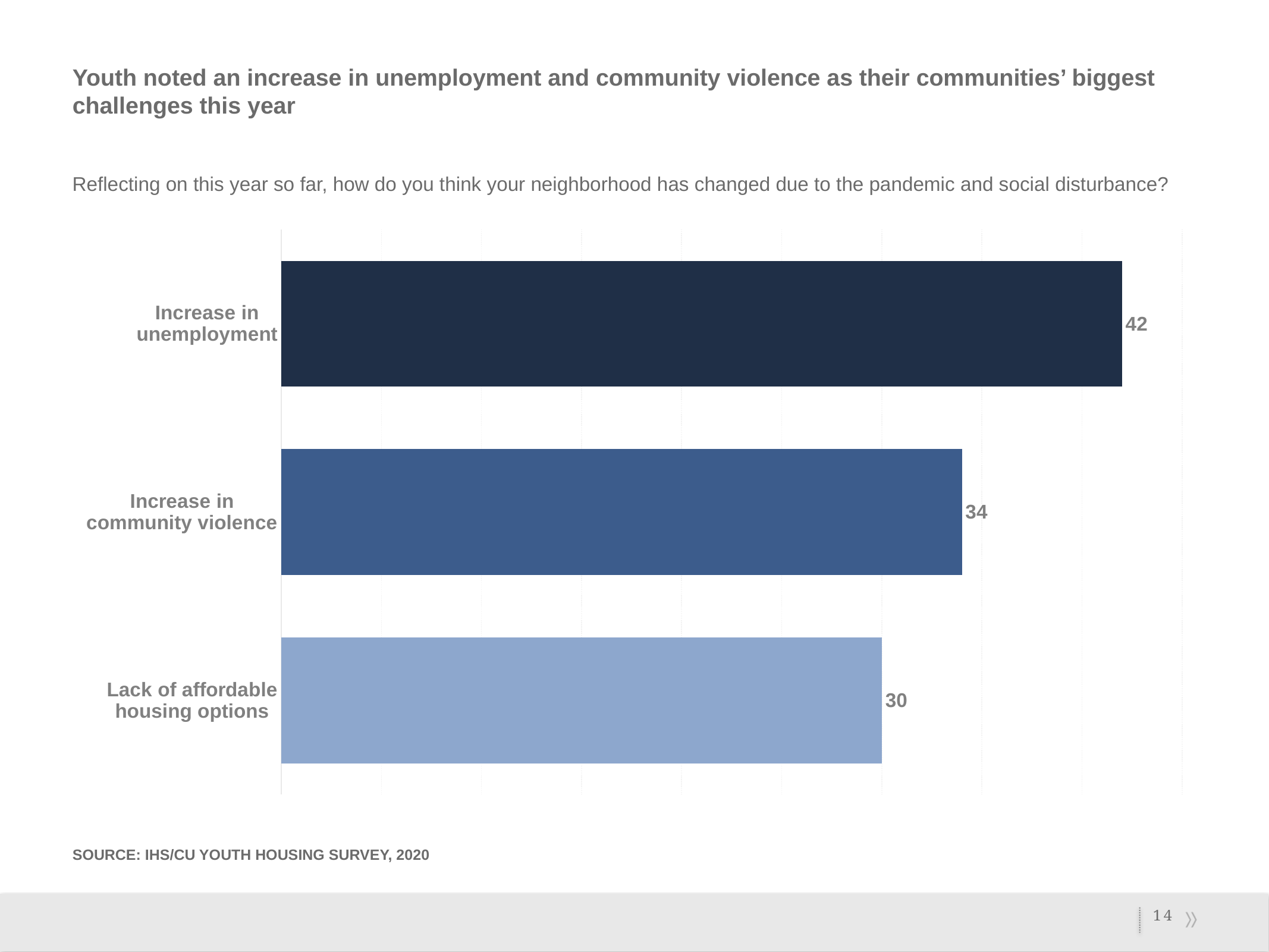
What is the value for Increase in community violence? 34 Which is larger, the value for Increase in community violence or the value for Lack of affordable housing options? Increase in community violence What is the difference between the values for Increase in community violence and Lack of affordable housing options? 4 What kind of chart is shown on the slide? Bar chart How many categories are shown in the chart? 3 Which category has the lowest value? Lack of affordable housing options What is the value for Increase in unemployment? 42 What is the difference between the values for Increase in unemployment and Increase in community violence? 8 Which category's bar is the darkest in colour? Increase in unemployment What is the value for Lack of affordable housing options? 30 Which category has the highest value? Increase in unemployment What is the source cited for the chart? IHS/CU Youth Housing Survey, 2020